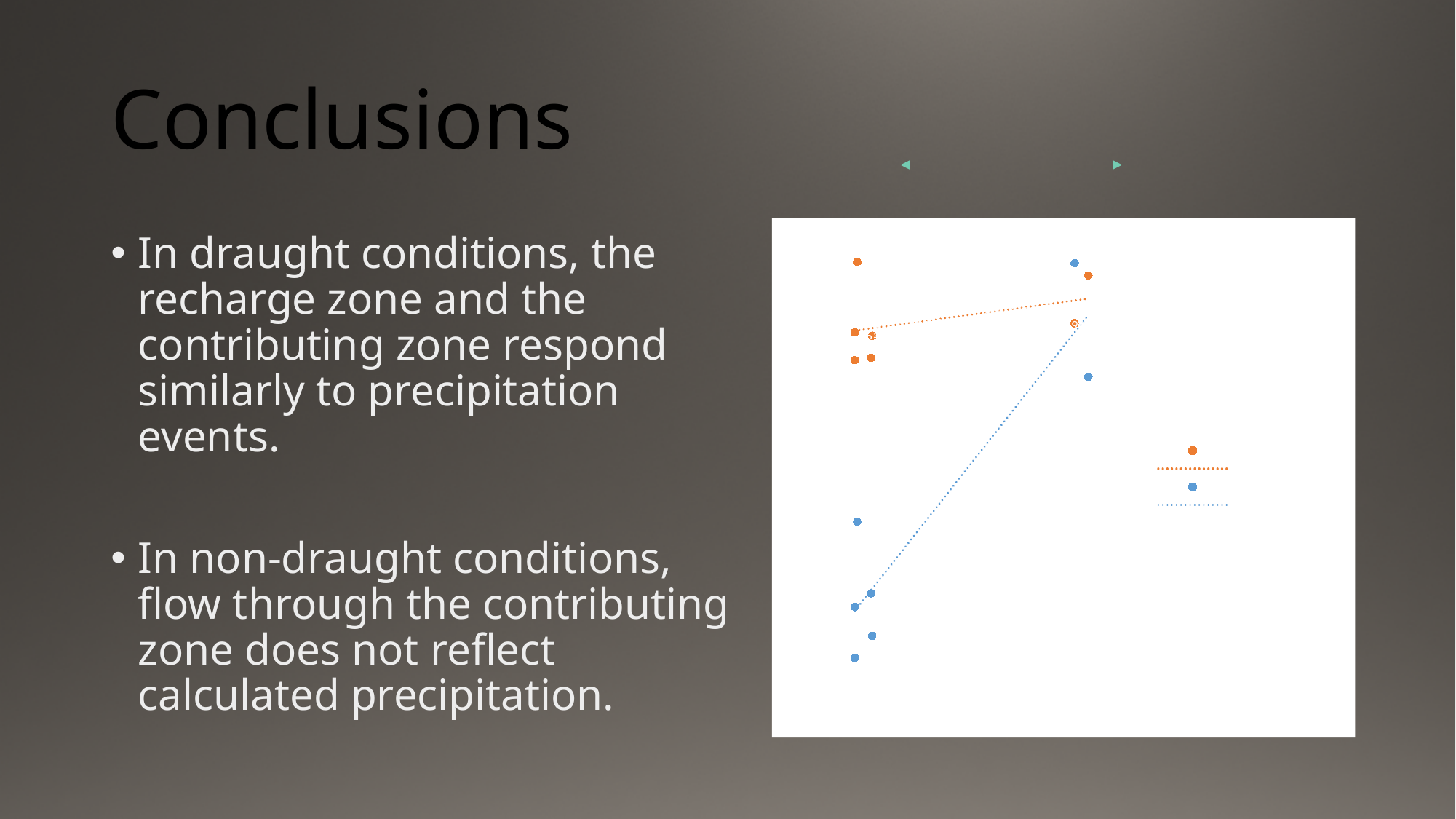
Are the trendlines in the chart drawn as solid or dotted lines? dotted What two colours are used for the data points in the chart? orange and blue Does the orange dotted trendline in the chart rise or fall from left to right? rise Which of the two trendlines in the chart is steeper, the blue one or the orange one? the blue one How many series does the legend of the chart list? 2 What kind of chart is shown on the right side of the slide? scatter chart Does the blue dotted trendline in the chart rise or fall from left to right? rise